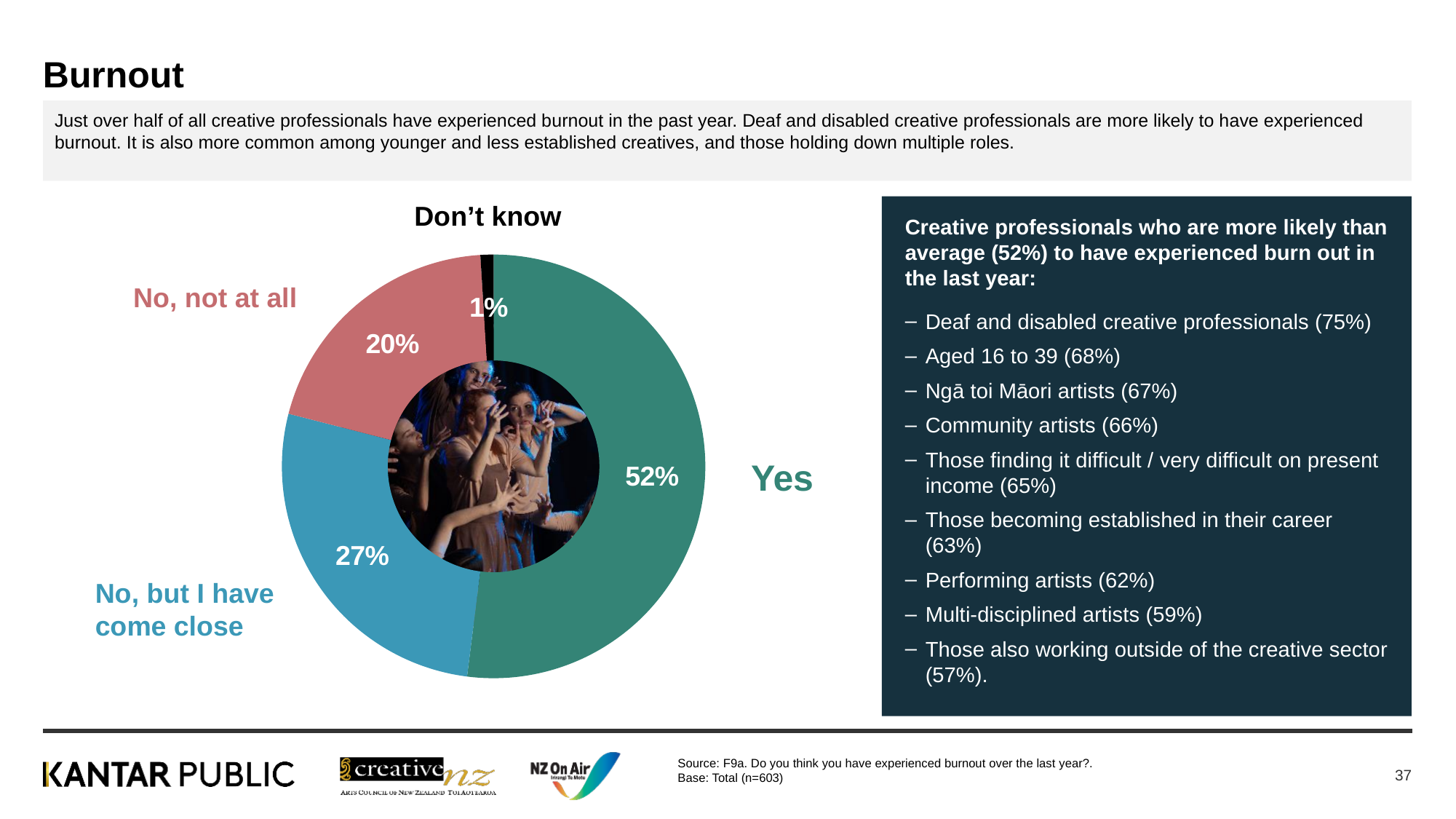
Which response has the smallest share of the pie? Don't know How many response categories are shown in the pie chart? 4 What is the difference in percentage points between "Yes" and "No, but I have come close"? 25 What percentage answered "No, not at all"? 20% What is the combined share of the two "No" responses ("No, but I have come close" and "No, not at all")? 47% Which response has the largest share of the pie? Yes What colour is the "Yes" slice of the pie chart? Green What percentage answered "No, but I have come close"? 27% What kind of chart is used to show the burnout responses? Pie chart Which is larger: the share for "No, but I have come close" or "No, not at all"? No, but I have come close What percentage of creative professionals answered "Yes" to having experienced burnout? 52% What percentage answered "Don't know"? 1%